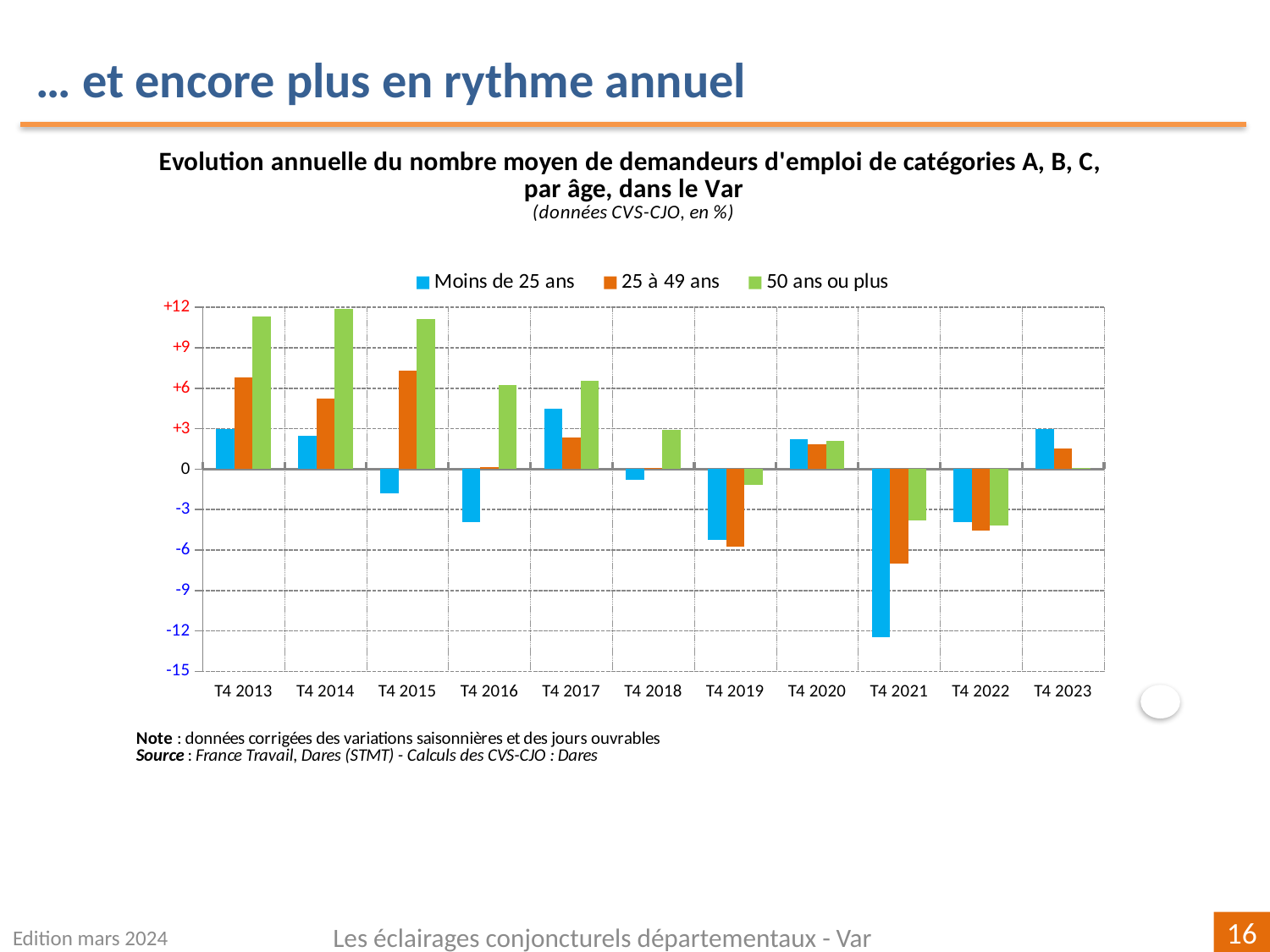
Is the value for '25 à 49 ans' in T4 2015 greater or less than +6? greater In T4 2017, which is larger: the value for 'Moins de 25 ans' or for '25 à 49 ans'? Moins de 25 ans For the series 'Moins de 25 ans', which quarter has the lowest value? T4 2021 In T4 2016, which is larger: the value for '50 ans ou plus' or for 'Moins de 25 ans'? 50 ans ou plus How many quarters (categories) are shown on the x axis? 11 Is the value for 'Moins de 25 ans' in T4 2021 greater or less than -9? less For the series '25 à 49 ans', which quarter has the lowest value? T4 2021 What kind of chart is shown on the slide? Bar chart Is the value for '50 ans ou plus' in T4 2013 greater or less than +9? greater How many series does the legend list? 3 Does the value for 'Moins de 25 ans' rise or fall from T4 2021 to T4 2023? rise Which colour represents the series '50 ans ou plus' in the legend? Green